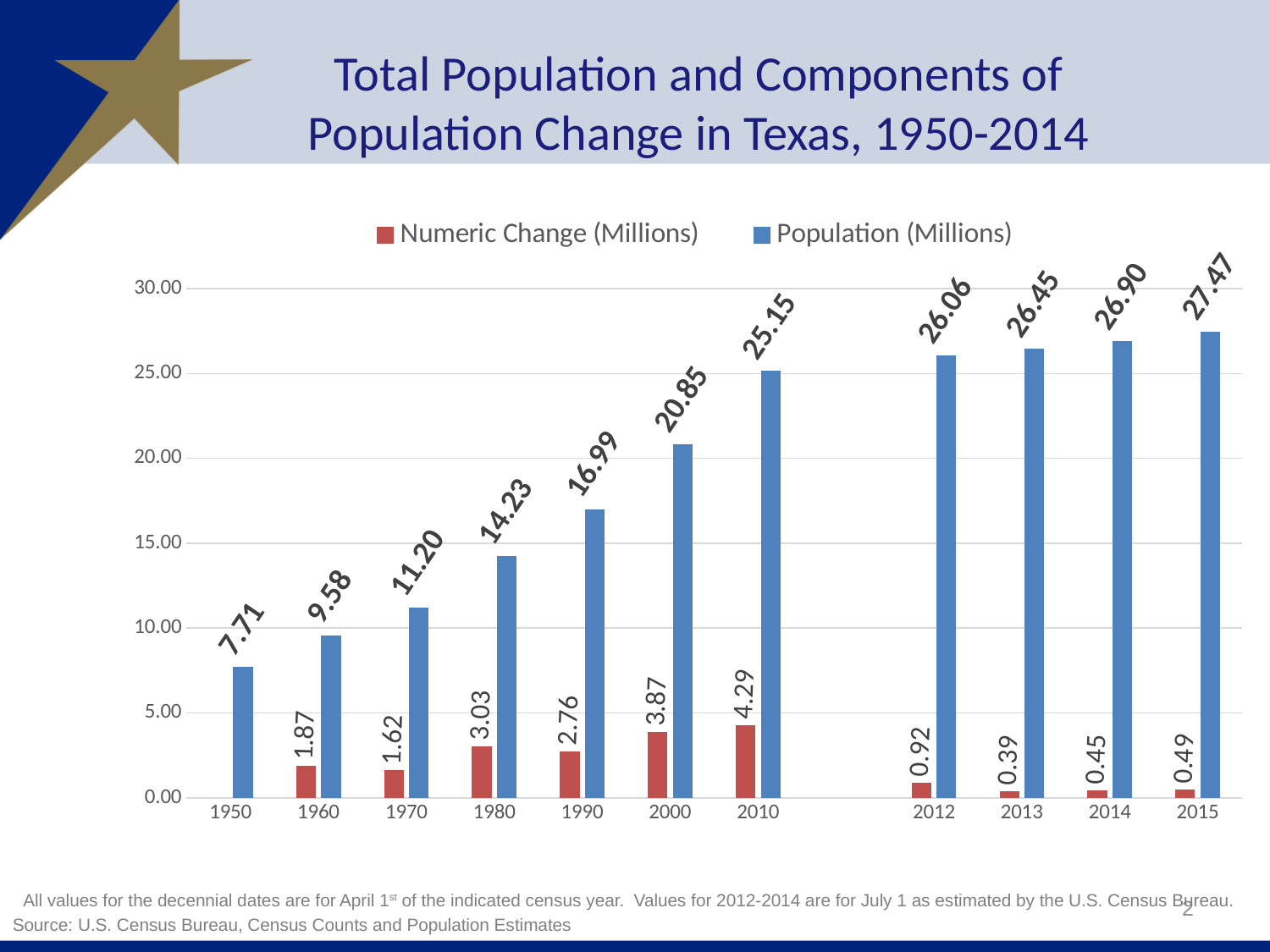
Which year has the lowest Numeric Change (Millions) value? 2013 Which year has the highest Numeric Change (Millions) value? 2010 What is the Population (Millions) value for 2010? 25.15 How many years are labelled on the x axis? 11 How many series does the legend list? 2 Is the Population (Millions) value for 1990 greater or less than 15.00? greater What is the difference between the Population (Millions) values for 2010 and 2000? 4.30 Which year has the highest Population (Millions) value? 2015 What is the Numeric Change (Millions) value for 1980? 3.03 Does the Population (Millions) series rise or fall from 1950 to 2015? rise Which is larger, the Numeric Change (Millions) for 1960 or for 1970? 1960 What is the Numeric Change (Millions) value for 2013? 0.39